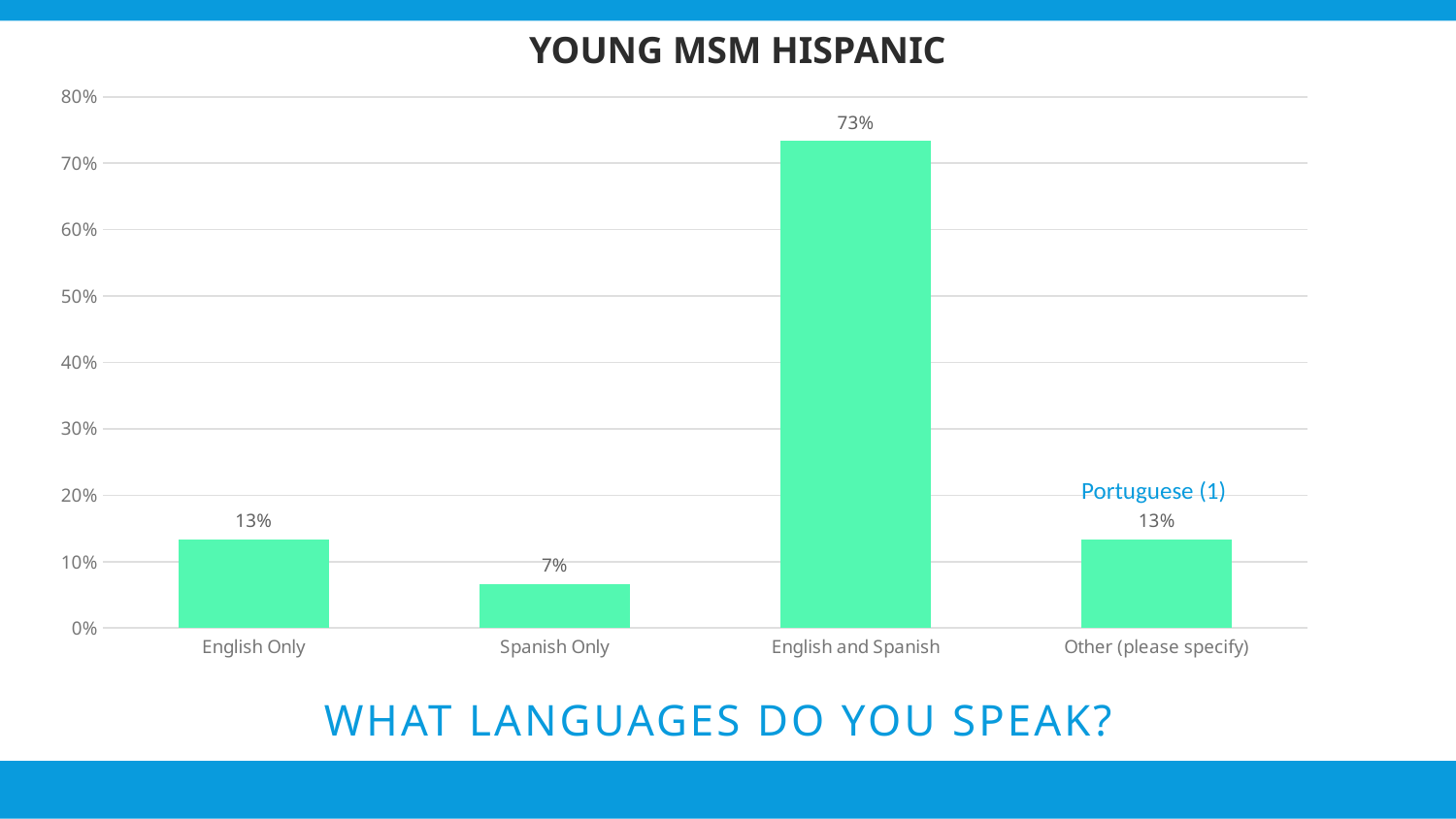
What is the value for Other (please specify)? 13% What is the value for Spanish Only? 7% How many categories are shown on the x axis? 4 Which category has the highest value? English and Spanish Is the value for English and Spanish greater or less than 70%? greater Which is larger, the value for English Only or the value for Spanish Only? English Only What is the value for English and Spanish? 73% What kind of chart is shown on the slide? bar chart What is the difference between the values for English and Spanish and English Only? 60% What is the title of the chart? YOUNG MSM HISPANIC Which category has the lowest value? Spanish Only What is the value for English Only? 13%